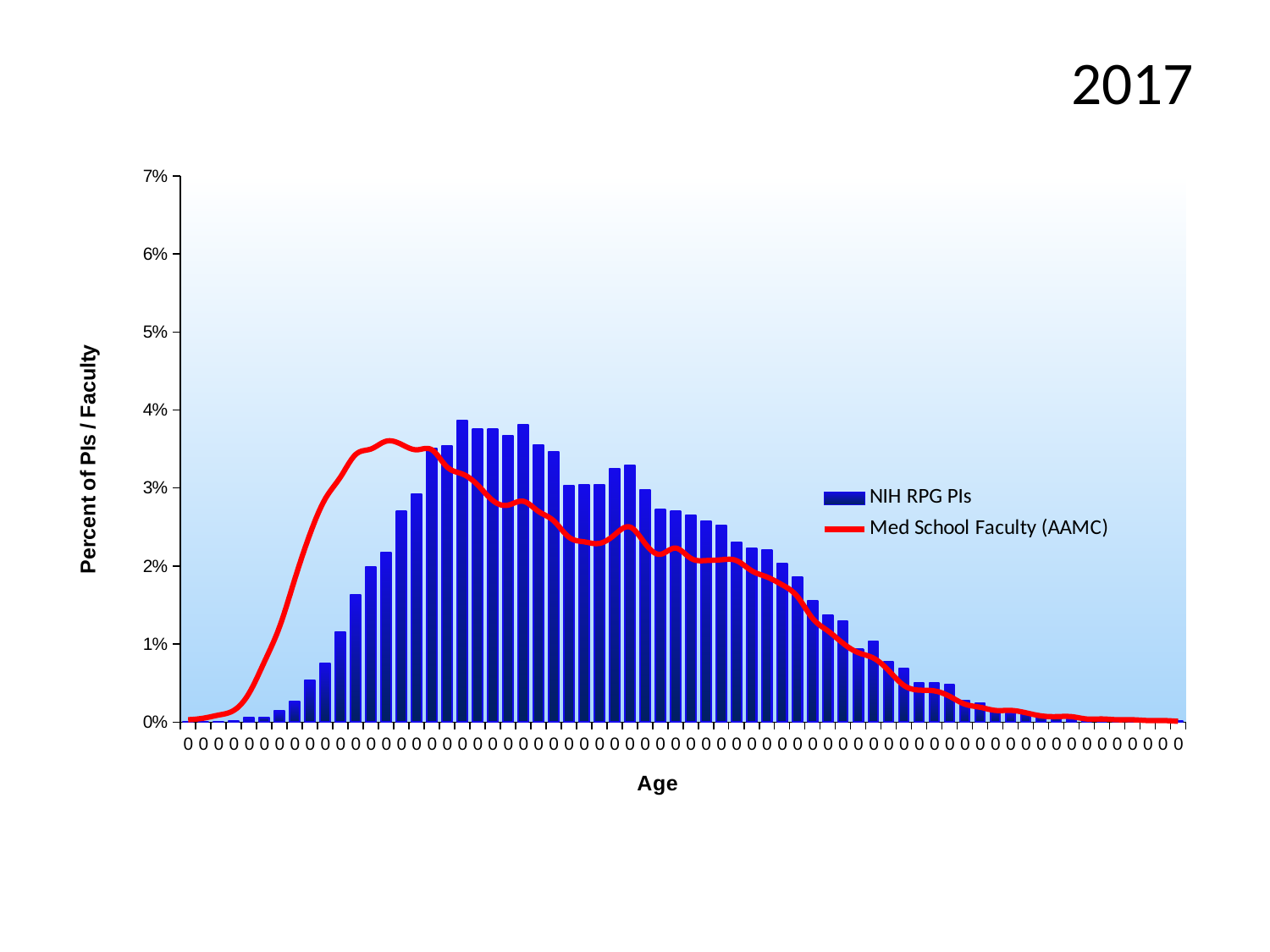
What are the two series named in the legend? NIH RPG PIs and Med School Faculty (AAMC) What is the highest value shown on the vertical axis? 7% What kind of chart is shown on the slide? A bar chart combined with a line chart How many series does the legend list? 2 What year is shown in the slide title? 2017 Do the NIH RPG PIs values rise or fall along the right-hand half of the x axis? fall Is the peak of the Med School Faculty (AAMC) line greater or less than 4%? less Is the highest bar for NIH RPG PIs greater or less than 3%? greater Which series reaches a higher peak value, NIH RPG PIs or Med School Faculty (AAMC)? NIH RPG PIs